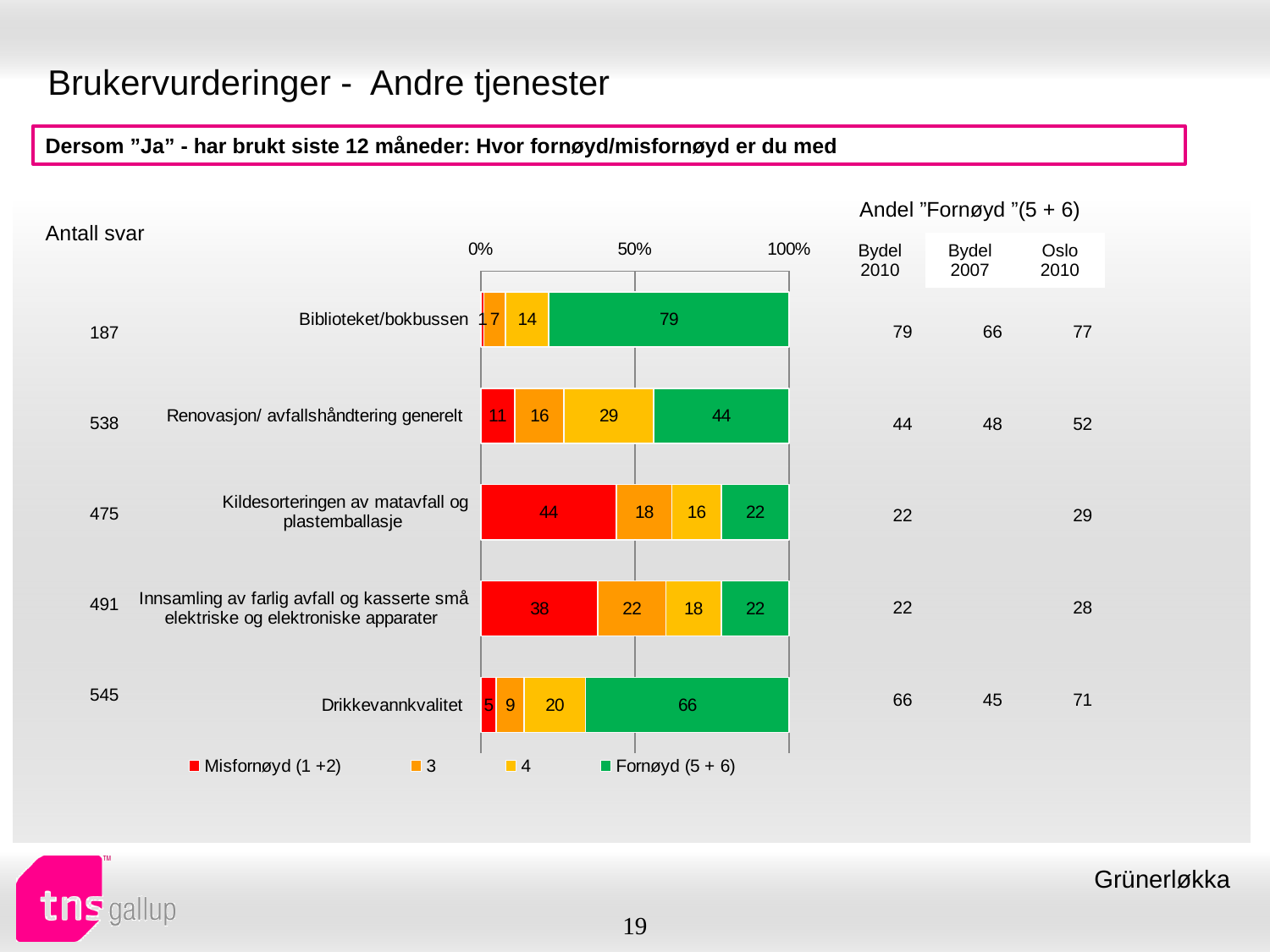
What is the total of the stacked bar for Renovasjon/ avfallshåndtering generelt? 100 Which category has the highest Fornøyd (5 + 6) value? Biblioteket/bokbussen How many categories are shown in the chart? 5 Which category has the lowest Misfornøyd (1 +2) value? Biblioteket/bokbussen What is the value of the '4' segment for Renovasjon/ avfallshåndtering generelt? 29 What is the value of the '3' segment for Drikkevannkvalitet? 9 Which has the larger Misfornøyd (1 +2) value: Kildesorteringen av matavfall og plastemballasje or Innsamling av farlig avfall og kasserte små elektriske og elektroniske apparater? Kildesorteringen av matavfall og plastemballasje What kind of chart is shown on the slide? Stacked bar chart What is the value of the Fornøyd (5 + 6) segment for Biblioteket/bokbussen? 79 How many series does the legend list? 4 What is the difference between the Fornøyd (5 + 6) values for Drikkevannkvalitet and Renovasjon/ avfallshåndtering generelt? 22 What is the value of the Misfornøyd (1 +2) segment for Kildesorteringen av matavfall og plastemballasje? 44